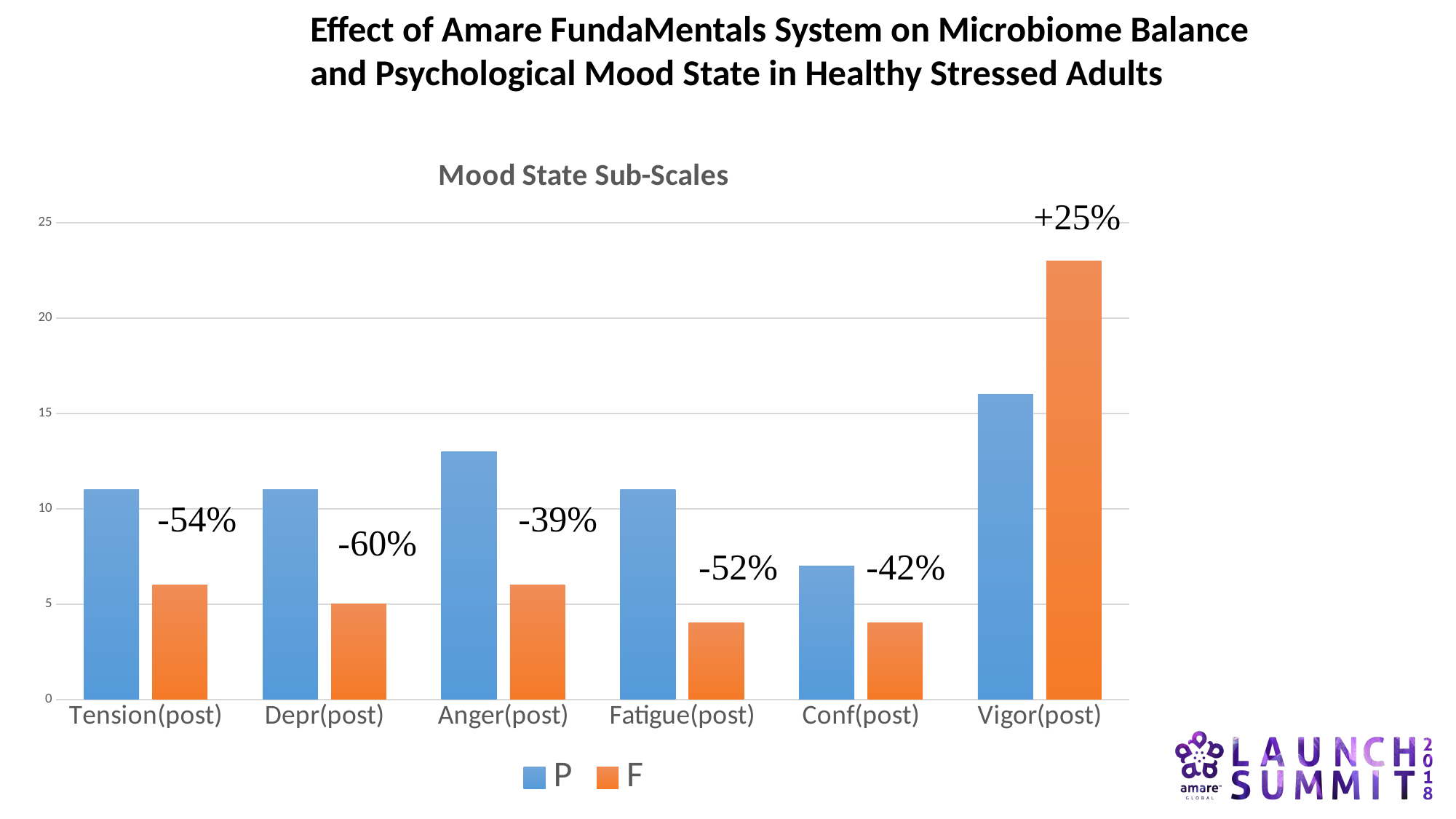
What percentage change is printed above the bars for Anger(post)? -39% Is the value of the F bar for Vigor(post) greater or less than 20? greater For Vigor(post), which series has the larger bar, P or F? F How many series does the legend list? 2 What is the title printed directly above the chart area? Mood State Sub-Scales What percentage change is printed above the bars for Depr(post)? -60% How many categories are shown on the x axis? 6 Which category has the highest F bar? Vigor(post) What kind of chart is shown on the slide? bar chart Is the value of the P bar for Conf(post) greater or less than 10? less Is the value of the P bar for Vigor(post) greater or less than 15? greater What percentage change is printed above the bars for Vigor(post)? +25%